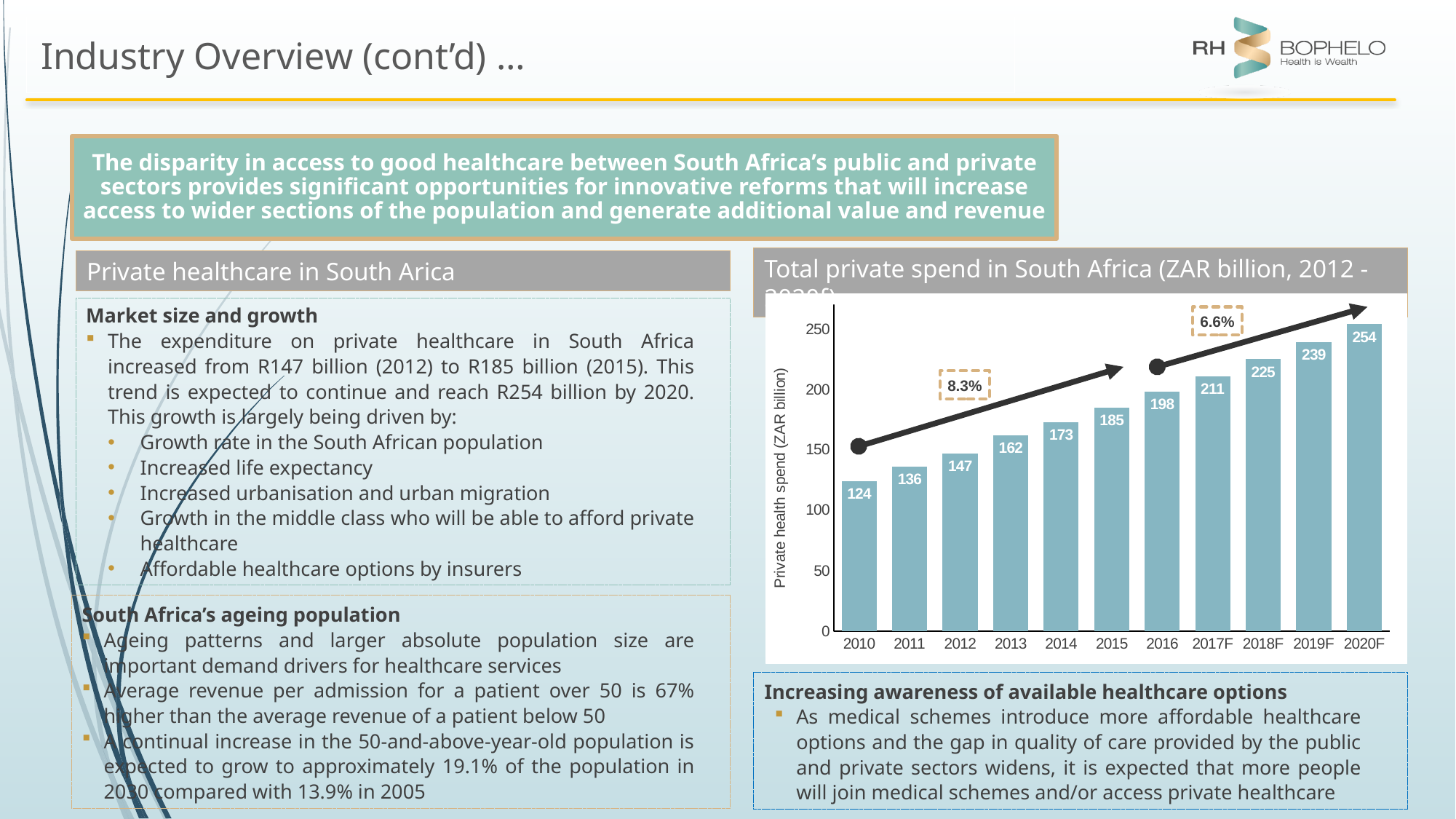
What is the private health spend value for 2012? 147 What is the private health spend value for 2016? 198 Do the private health spend values rise or fall from 2010 to 2020F? rise Is the value for 2011 greater or less than 150? less What kind of chart is used to show total private spend in South Africa? bar chart How many years are shown on the x axis of the chart? 11 Which is larger, the private health spend for 2014 or for 2017F? 2017F What is the difference in private health spend between 2015 and 2012? 38 Which year has the highest private health spend? 2020F What is the private health spend value for 2020F? 254 What is the y-axis label of the chart? Private health spend (ZAR billion) Which year has the lowest private health spend? 2010